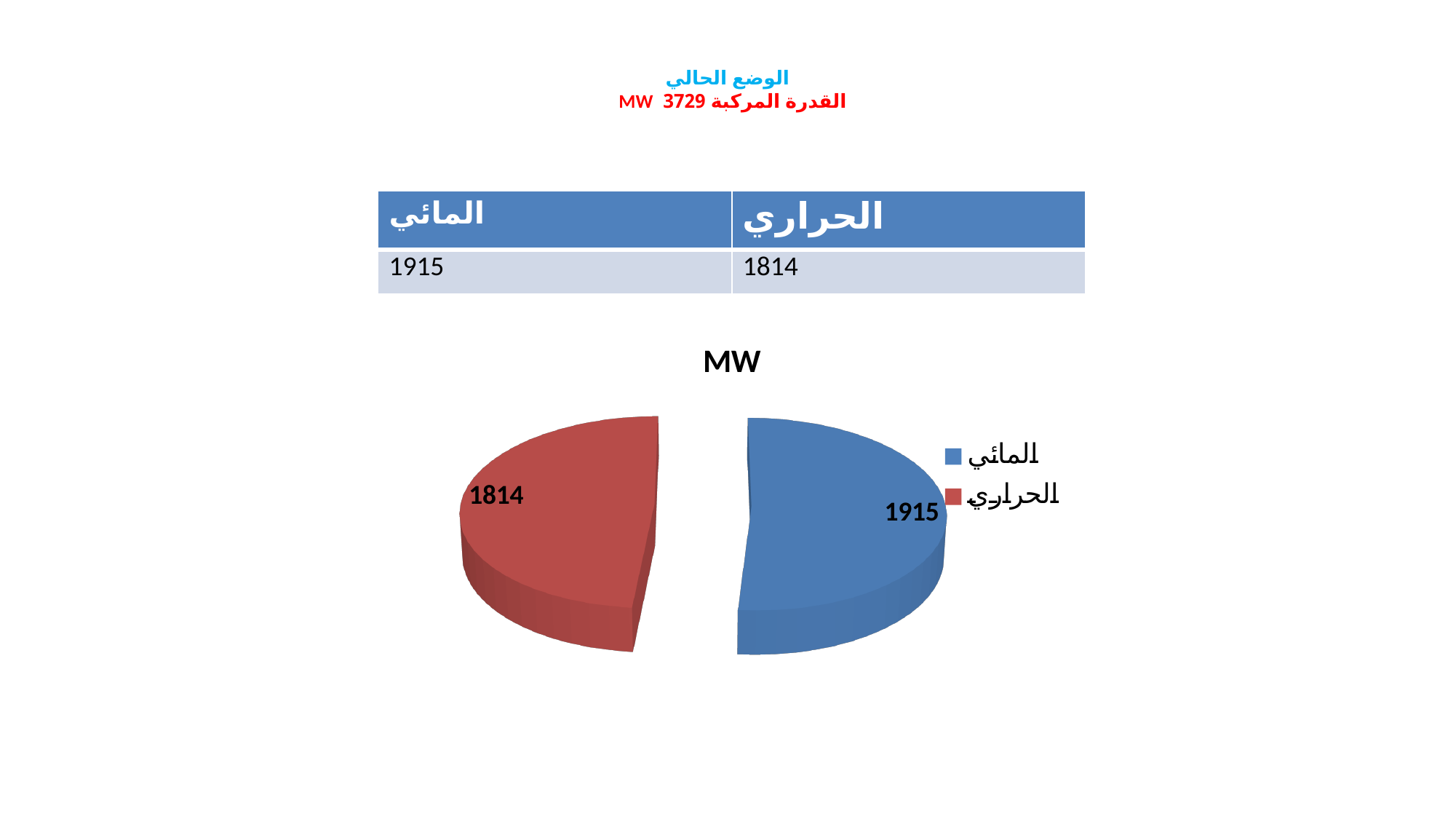
What is the difference between the المائي and الحراري values in the MW pie chart? 101 What is the value of the المائي slice in the MW pie chart? 1915 How many slices does the MW pie chart have? 2 What colour is the الحراري slice in the MW pie chart? red What is the total of the two slices in the MW pie chart? 3729 What kind of chart is shown on the slide? pie chart Which slice of the MW pie chart is the largest? المائي How many entries does the legend of the MW pie chart list? 2 Which slice of the MW pie chart is the smallest? الحراري What is the value of the الحراري slice in the MW pie chart? 1814 Which is larger in the MW pie chart, المائي or الحراري? المائي What is the title of the pie chart? MW